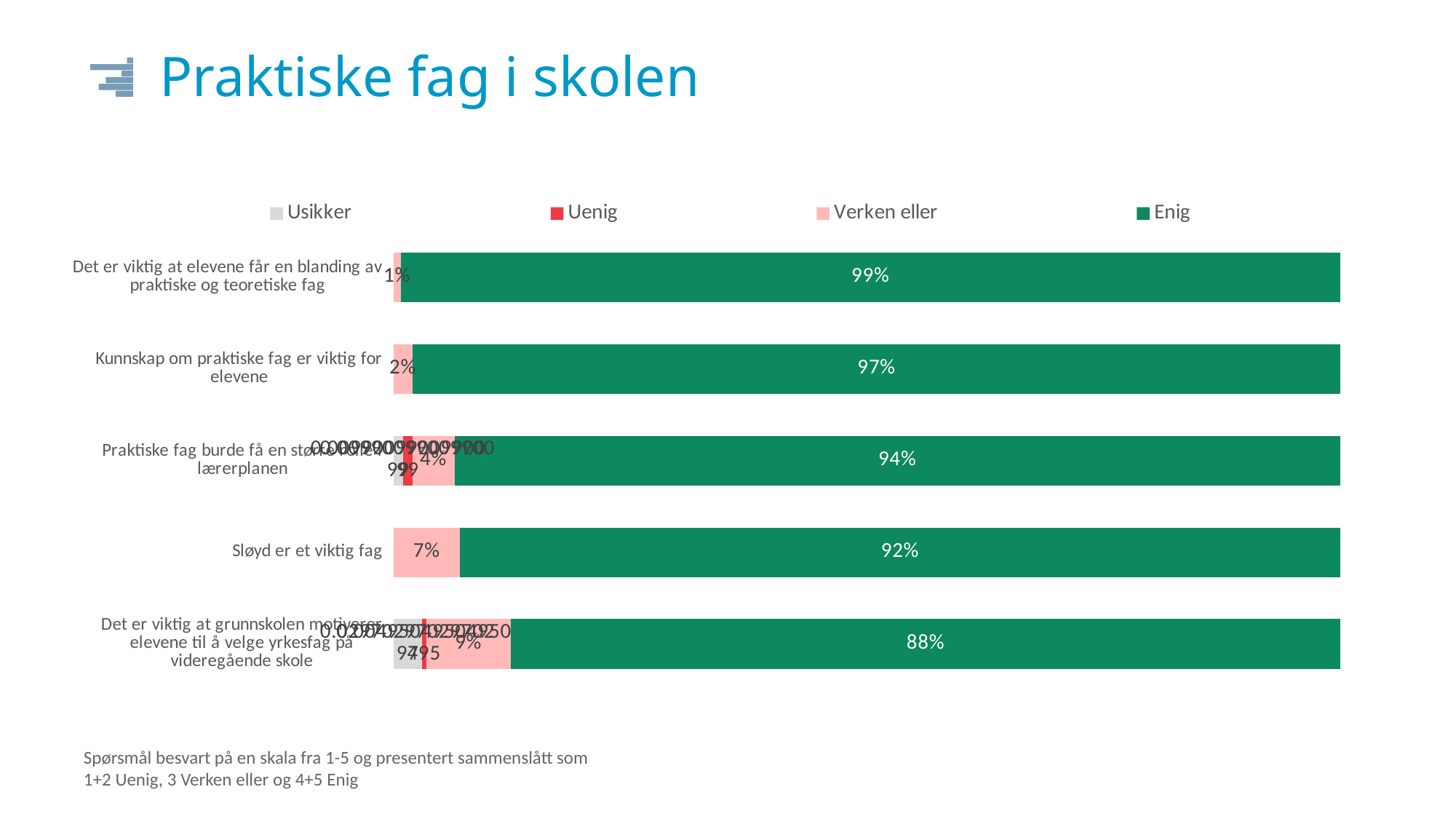
What is the difference in "Enig" percentage between "Det er viktig at elevene får en blanding av praktiske og teoretiske fag" and "Sløyd er et viktig fag"? 7 percentage points Which statement has the lowest "Enig" percentage? Det er viktig at grunnskolen motiverer elevene til å velge yrkesfag på videregående skole What is the "Verken eller" share for "Kunnskap om praktiske fag er viktig for elevene"? 2% What is the "Verken eller" share for "Sløyd er et viktig fag"? 7% What kind of chart is shown on the slide? Stacked bar chart How many series does the legend list? 4 How many statements (bars) are shown in the chart? 5 Do the "Enig" percentages increase or decrease going from the top bar to the bottom bar? Decrease Which has a larger "Enig" share: "Sløyd er et viktig fag" or "Kunnskap om praktiske fag er viktig for elevene"? Kunnskap om praktiske fag er viktig for elevene Which statement has the highest "Enig" percentage? Det er viktig at elevene får en blanding av praktiske og teoretiske fag What percentage answered "Enig" for "Kunnskap om praktiske fag er viktig for elevene"? 97% What percentage answered "Enig" for "Sløyd er et viktig fag"? 92%